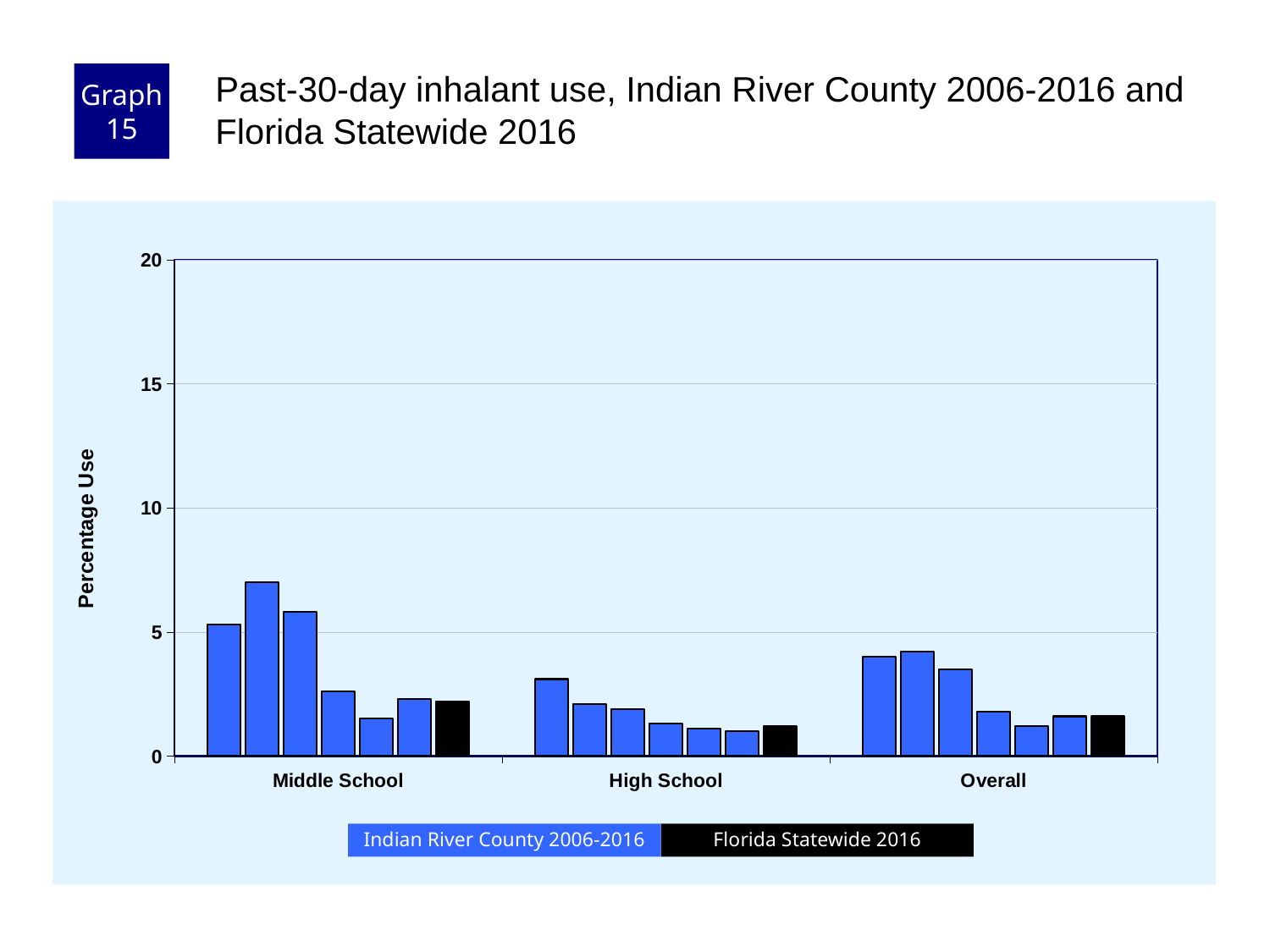
Which is larger, the Florida Statewide 2016 bar for Middle School or the Florida Statewide 2016 bar for High School? Middle School Do the Indian River County bars for High School generally rise or fall from left to right? fall What kind of chart is shown on the slide? bar chart What colour are the Florida Statewide 2016 bars? black Is the tallest Middle School bar greater or less than 10? less Is the tallest Middle School bar greater or less than 5? greater What is the label on the vertical axis? Percentage Use Which category group contains the tallest bar in the chart? Middle School How many school-level categories are shown along the x axis? 3 Is the Florida Statewide 2016 value for High School greater or less than 5? less How many series does the legend list? 2